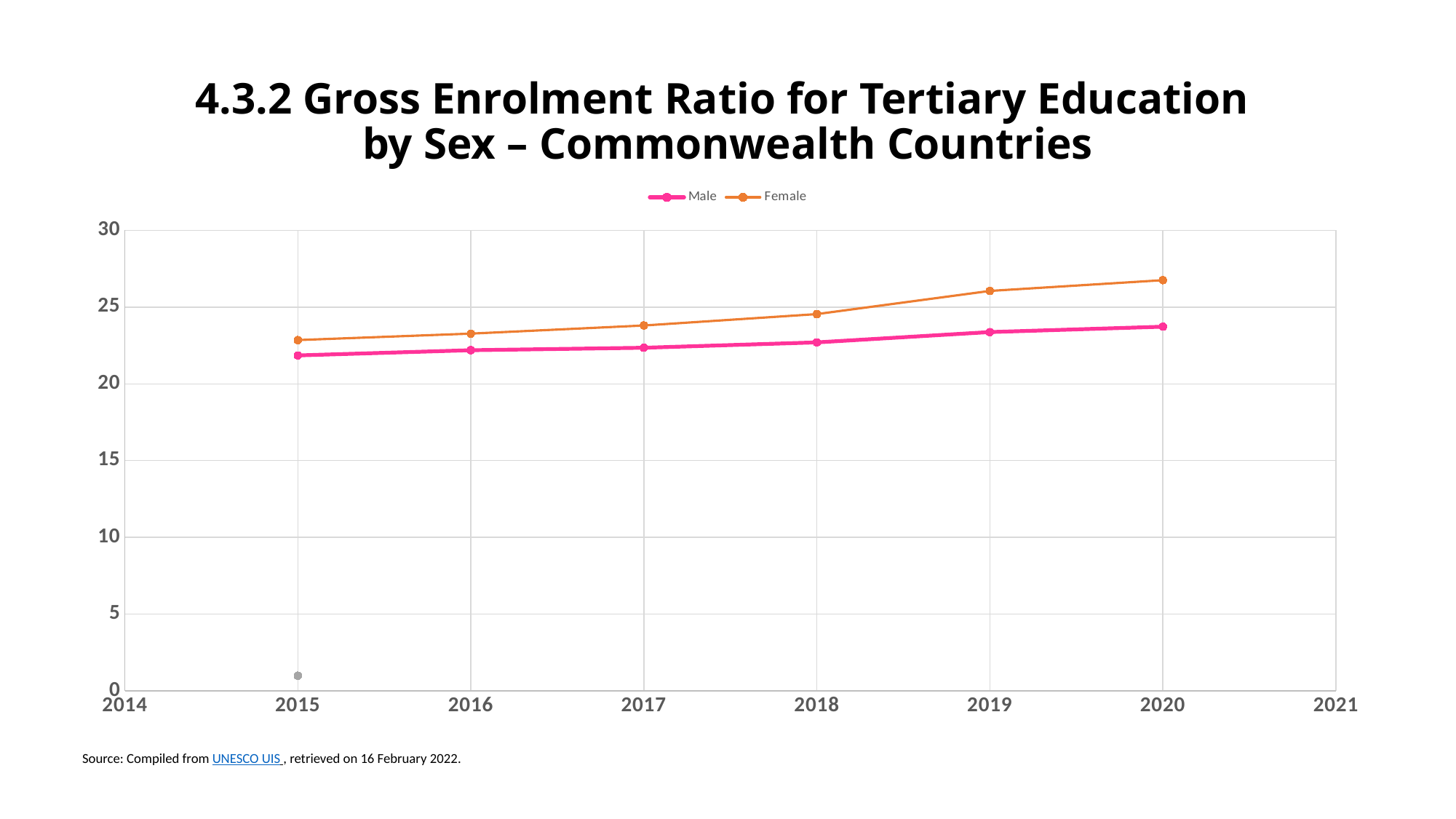
Is the value for Female in 2015 greater or less than 25? less Is the value for Male in 2020 greater or less than 25? less Do the Female values rise or fall from 2015 to 2020? rise How many data points are plotted for the Female series? 6 Is the value for Male in 2018 greater or less than 20? greater In which year is the Male series at its lowest? 2015 What kind of chart is shown on the slide? Line chart In which year is the Female series at its highest? 2020 How many series does the legend list? 2 In 2020, which series has the larger value, Male or Female? Female